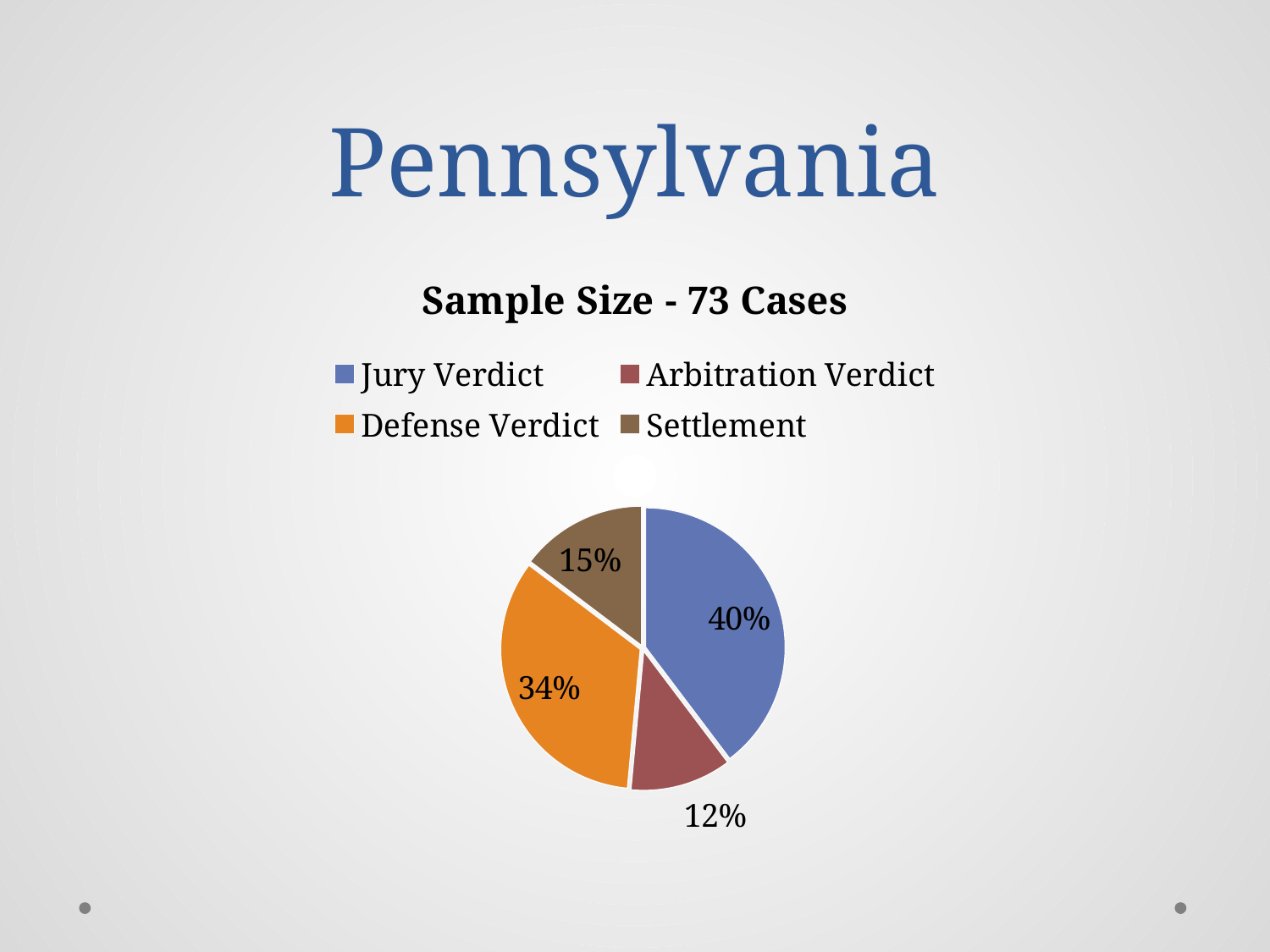
What type of chart is shown on the slide? Pie chart What is the title of the chart? Sample Size - 73 Cases What percentage of cases resulted in a Defense Verdict? 34% Which is larger, the Settlement share or the Arbitration Verdict share? Settlement How many categories does the pie chart have? 4 What percentage of cases resulted in a Jury Verdict? 40% Which outcome has the largest share of the pie? Jury Verdict What percentage of cases resulted in an Arbitration Verdict? 12% What percentage of cases ended in Settlement? 15% Which outcome has the smallest share of the pie? Arbitration Verdict What is the difference in percentage points between Jury Verdict and Defense Verdict? 6 Which colour represents Defense Verdict in the legend? Orange